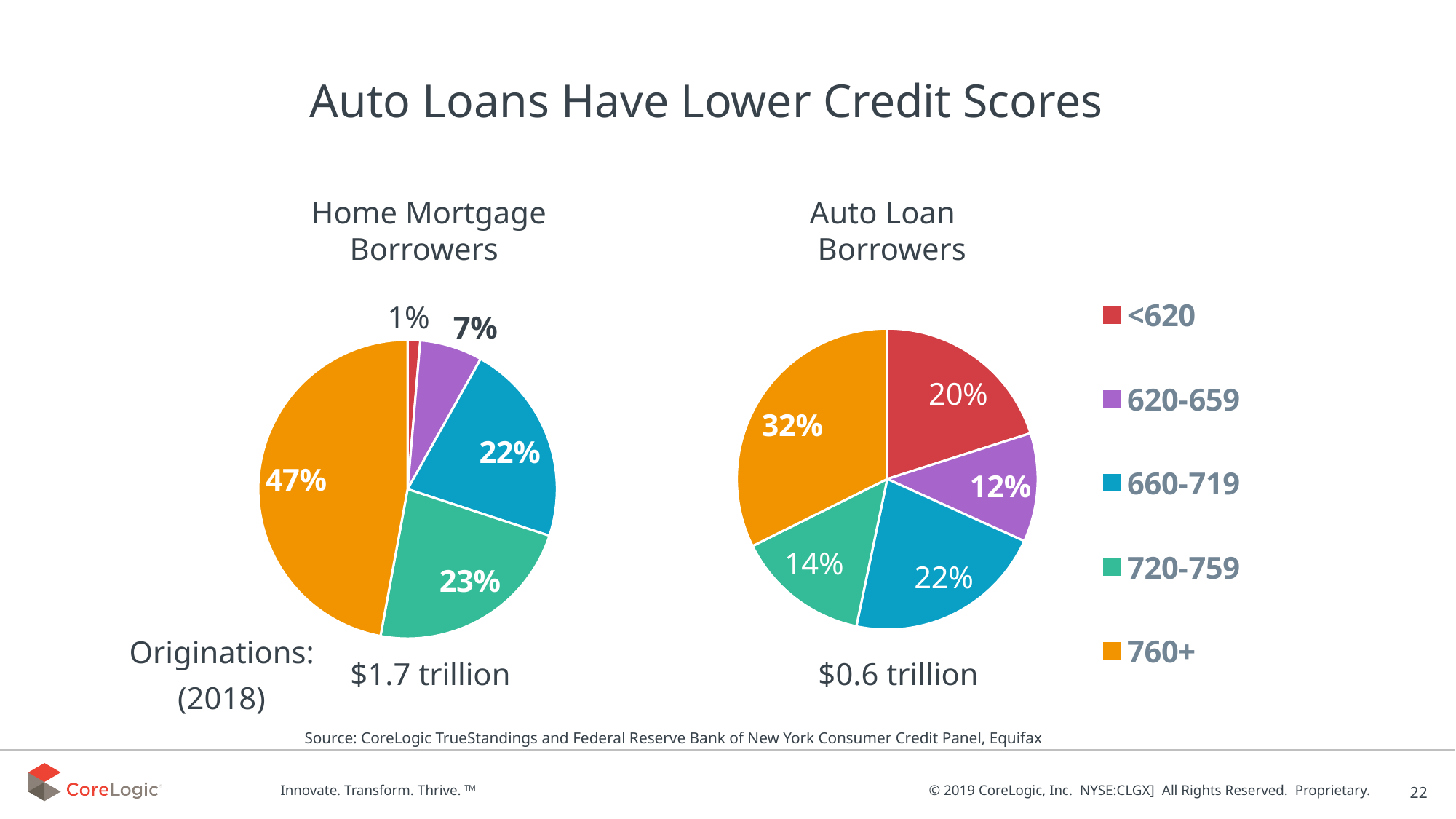
In the Home Mortgage Borrowers chart, what share of borrowers fall in the 720-759 credit score range? 23% In the Home Mortgage Borrowers chart, which credit score range has the smallest share? <620 In the Auto Loan Borrowers chart, what share of borrowers fall in the 620-659 credit score range? 12% What is the difference between the 760+ share in the Home Mortgage Borrowers chart and the 760+ share in the Auto Loan Borrowers chart? 15 percentage points What colour represents the 660-719 credit score range in the legend? Blue In the Home Mortgage Borrowers chart, what share of borrowers have a credit score of 760+? 47% In the Auto Loan Borrowers chart, what share of borrowers have a credit score below 620? 20% In the Auto Loan Borrowers chart, which credit score range has the largest share? 760+ In the Auto Loan Borrowers chart, which is larger: the share for <620 or the share for 720-759? <620 What type of chart is used for the Home Mortgage Borrowers data? Pie chart How many credit score ranges does the legend list? 5 In the Auto Loan Borrowers chart, which credit score range has the smallest share? 620-659